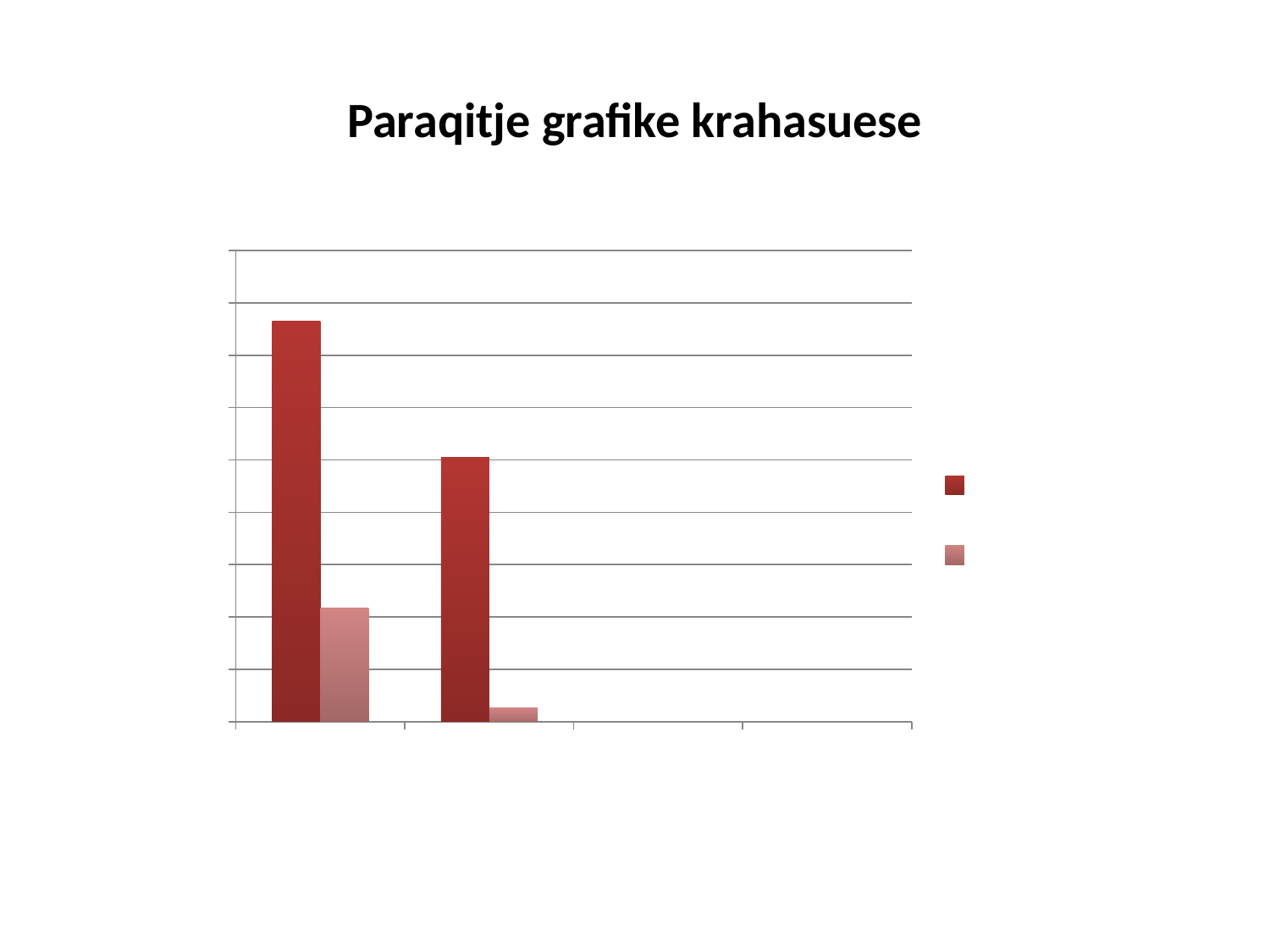
Do the dark red bars rise or fall from left to right? fall What kind of chart is shown on the slide? bar chart In the leftmost group of bars, which bar is taller, the dark red one or the light pink one? the dark red one Which bar on the chart is the tallest? the dark red bar in the left group Do the light pink bars rise or fall from left to right? fall What colour is the first series in the legend? dark red Which bar on the chart is the shortest? the light pink bar in the right group How many groups of bars are plotted on the chart? 2 Which group of bars has the taller dark red bar, the left group or the right group? the left group How many series does the legend list? 2 What is the title of the chart on the slide? Paraqitje grafike krahasuese Which group of bars has the taller light pink bar, the left group or the right group? the left group